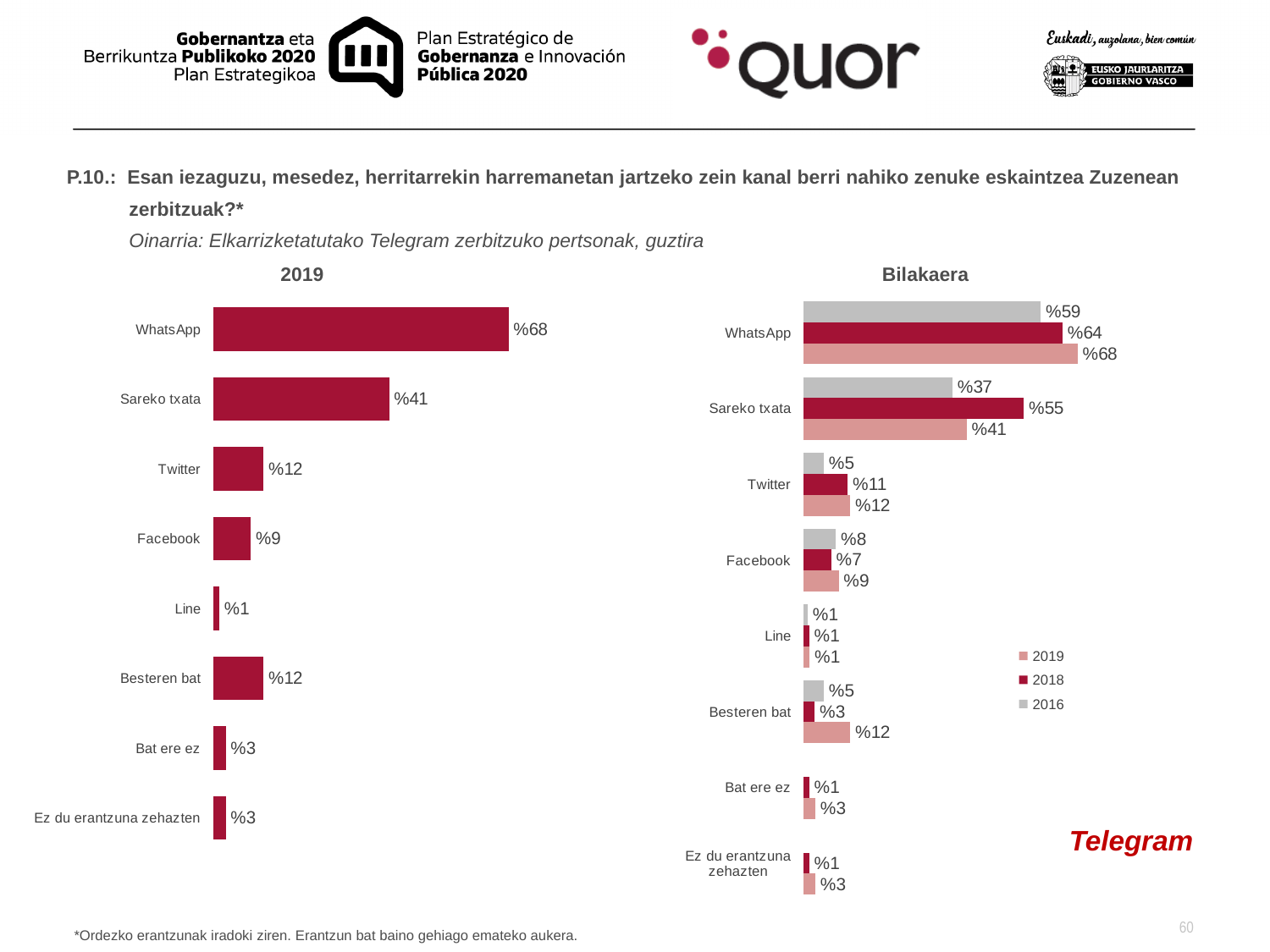
What kind of chart is the "2019" chart? Bar chart In the "Bilakaera" chart, which is larger for Twitter: the 2016 value or the 2019 value? 2019 In the "2019" chart, which category has the highest value? WhatsApp In the "Bilakaera" chart, what is the difference between the 2019 and 2018 values for Besteren bat? %9 In the "Bilakaera" chart, what is the value for Sareko txata in 2018? %55 In the "Bilakaera" chart, what is the value for WhatsApp in 2016? %59 In the "2019" chart, which category has the lowest value? Line In the "2019" chart, what is the difference between the values for WhatsApp and Sareko txata? %27 In the "Bilakaera" chart, how many series does the legend list? 3 In the "2019" chart, how many categories are shown? 8 In the "2019" chart, what is the value for Sareko txata? %41 In the "2019" chart, what is the value for WhatsApp? %68